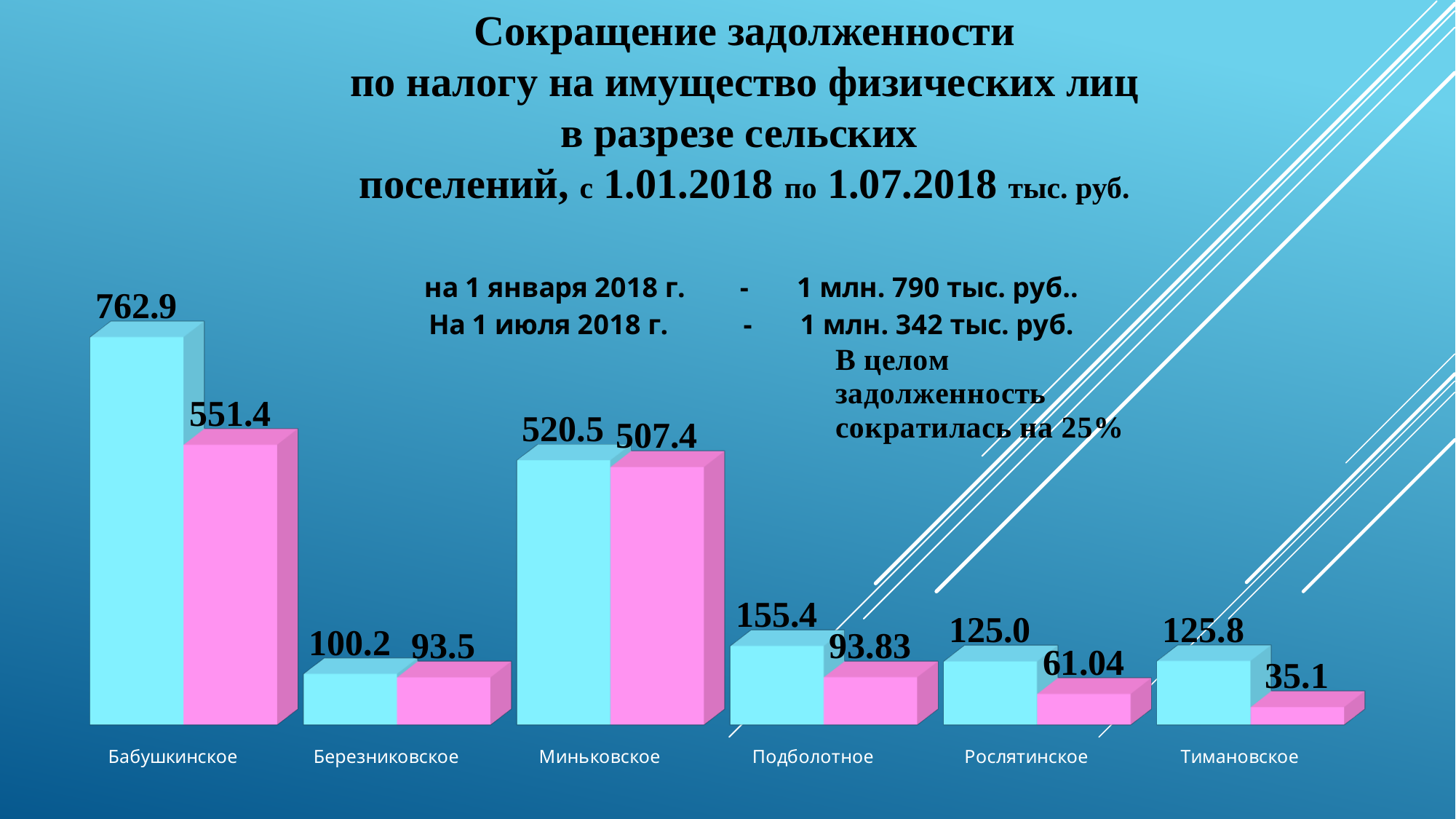
What is the value of the light blue bar for Бабушкинское? 762.9 How many bars are shown for each settlement? 2 Which category has the lowest pink bar? Тимановское How many categories (settlements) are shown on the x axis? 6 Which category has the highest light blue bar? Бабушкинское What kind of chart is shown on the slide? Bar chart What is the difference between the light blue and pink bars for Тимановское? 90.7 What is the value of the pink bar for Тимановское? 35.1 What is the difference between the light blue and pink bars for Бабушкинское? 211.5 What is the value of the pink bar for Подболотное? 93.83 Which is larger: the light blue bar for Березниковское or the light blue bar for Подболотное? Подболотное What is the value of the light blue bar for Миньковское? 520.5